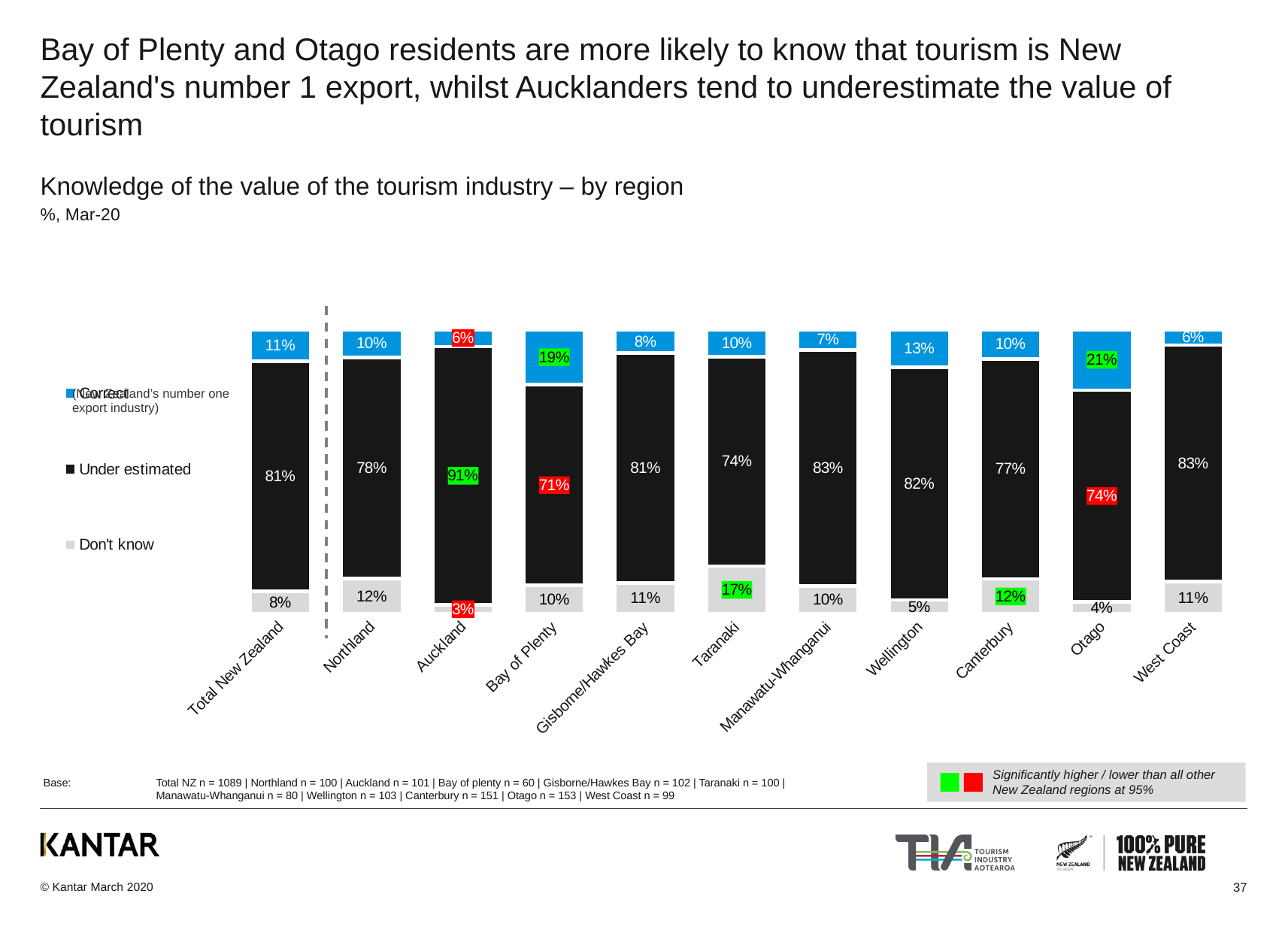
What kind of chart is shown on the slide? Stacked bar chart How many series does the legend list? 3 What does the green highlighting on a data label indicate, according to the note on the slide? Significantly higher than all other New Zealand regions at 95% Which region has the lowest 'Don't know' percentage? Auckland What is the 'Under estimated' value for Auckland? 91% What is the difference between the 'Correct' values for Bay of Plenty and Total New Zealand? 8% How many regions (including Total New Zealand) are shown on the x axis? 11 What percentage of Otago residents correctly identified tourism as New Zealand's number one export industry? 21% Which region has the highest 'Correct' percentage? Otago Which is larger, the 'Under estimated' value for Wellington or for Canterbury? Wellington Which region has the lowest 'Under estimated' percentage? Bay of Plenty What is the 'Don't know' value for Taranaki? 17%